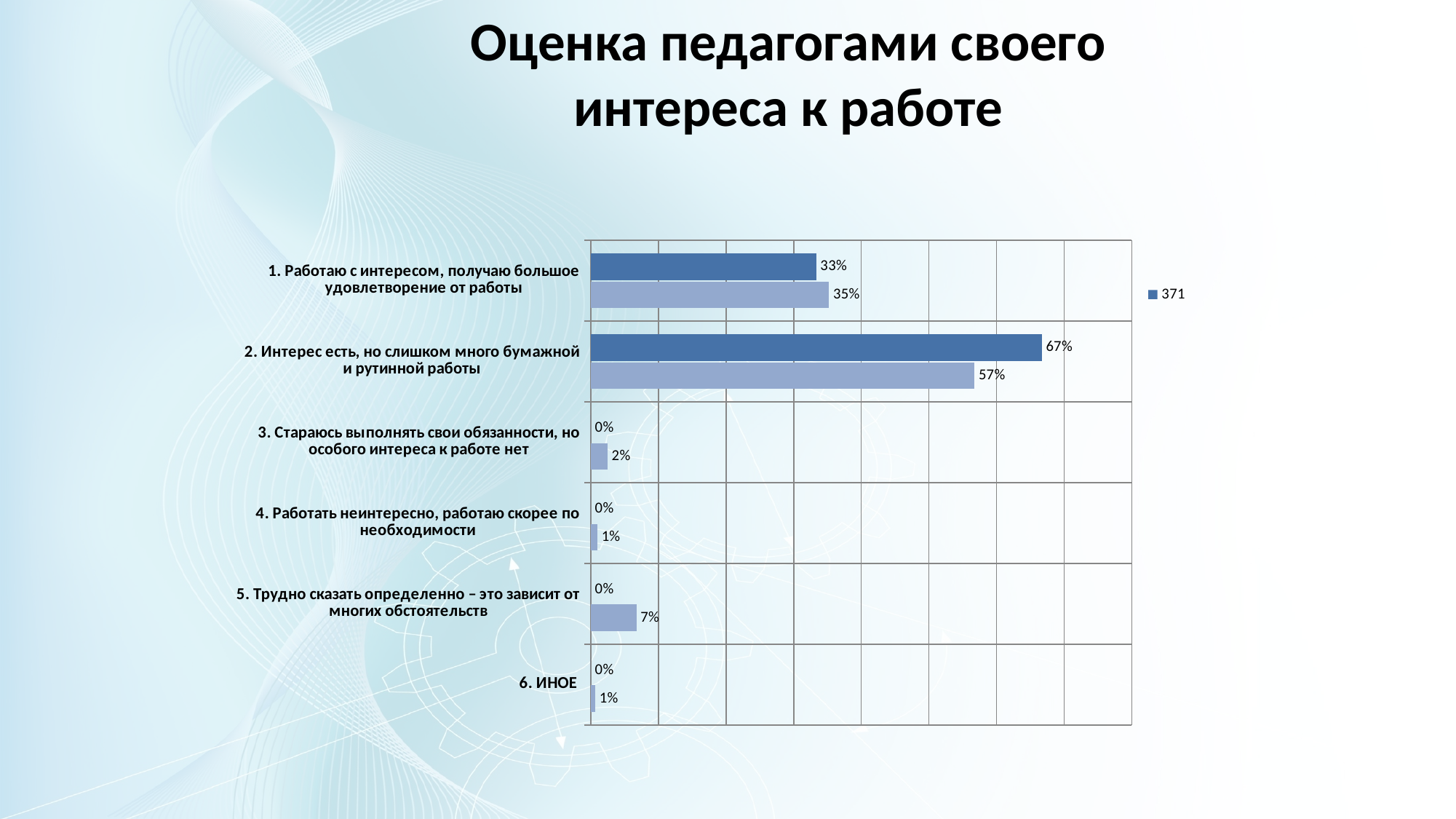
Which category has the highest value among the dark blue bars? 2. Интерес есть, но слишком много бумажной и рутинной работы What is the value of the dark blue bar for category "6. ИНОЕ"? 0% What is the value of the dark blue bar for category "2. Интерес есть, но слишком много бумажной и рутинной работы"? 67% What is the difference between the dark blue and light blue bars for category "2. Интерес есть, но слишком много бумажной и рутинной работы"? 10% What is the value of the light blue bar for category "5. Трудно сказать определенно – это зависит от многих обстоятельств"? 7% What entry is listed in the chart legend? 371 What is the value of the light blue bar for category "3. Стараюсь выполнять свои обязанности, но особого интереса к работе нет"? 2% For category "1. Работаю с интересом, получаю большое удовлетворение от работы", which bar is larger, the dark blue or the light blue? light blue What type of chart is shown on the slide? bar chart How many categories are shown on the chart? 6 What is the value of the light blue bar for category "1. Работаю с интересом, получаю большое удовлетворение от работы"? 35% What is the difference between the light blue bars for category 2 and category 1? 22%